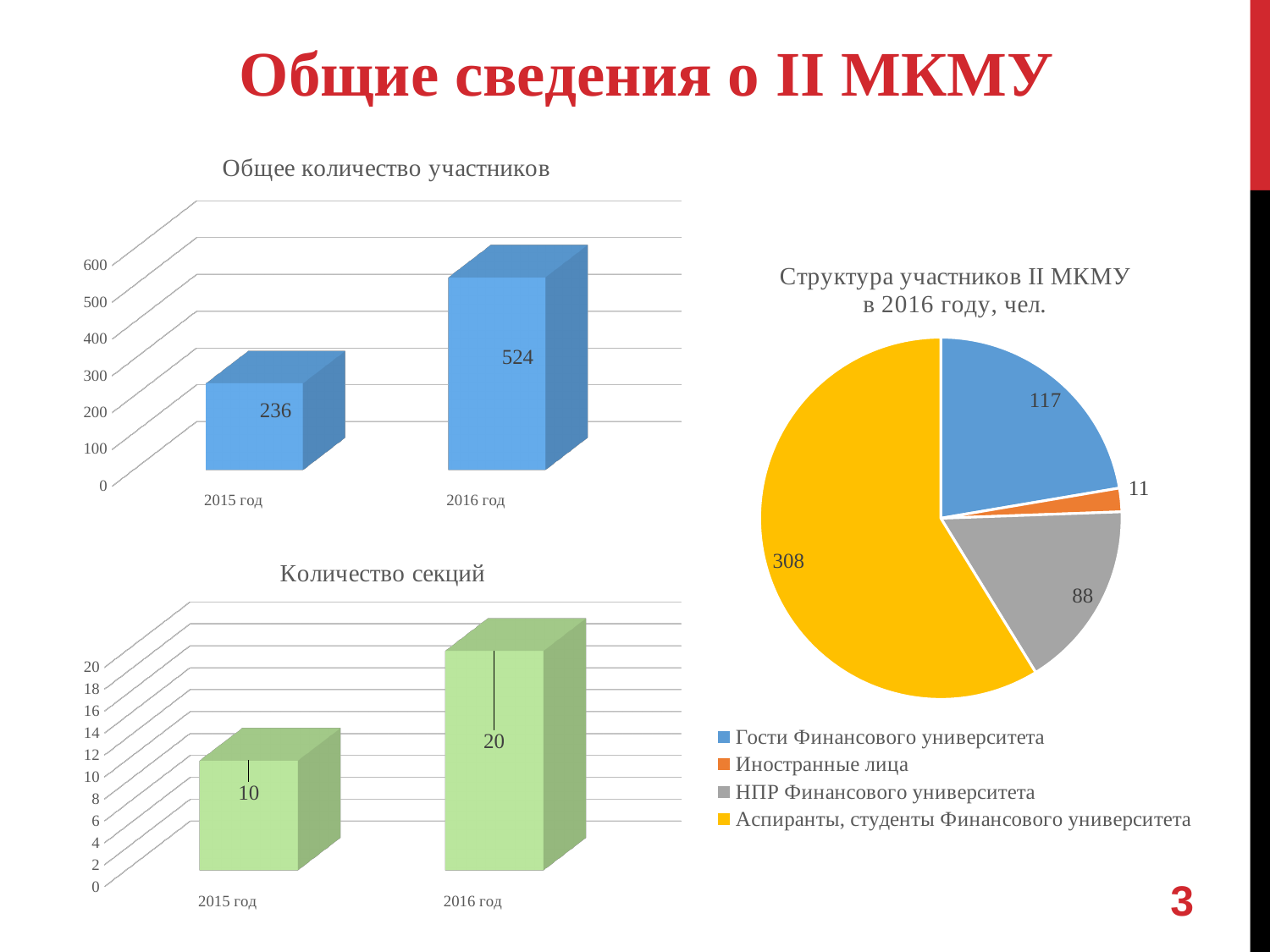
In the chart titled "Количество секций", what is the value for 2015 год? 10 In the pie chart "Структура участников II МКМУ в 2016 году, чел.", what colour is the slice for НПР Финансового университета? gray In the chart titled "Общее количество участников", what is the value for 2016 год? 524 In the chart titled "Количество секций", what is the difference between 2016 год and 2015 год? 10 What kind of chart is "Общее количество участников"? bar chart In the chart titled "Общее количество участников", what is the value for 2015 год? 236 In the chart titled "Общее количество участников", by how much did the number of participants increase from 2015 год to 2016 год? 288 How many categories does the legend of the pie chart "Структура участников II МКМУ в 2016 году, чел." list? 4 In the pie chart "Структура участников II МКМУ в 2016 году, чел.", which category has the largest value? Аспиранты, студенты Финансового университета In the chart titled "Количество секций", do the values rise or fall from 2015 год to 2016 год? rise In the pie chart "Структура участников II МКМУ в 2016 году, чел.", which is larger: Гости Финансового университета or НПР Финансового университета? Гости Финансового университета In the pie chart "Структура участников II МКМУ в 2016 году, чел.", what is the value for Иностранные лица? 11